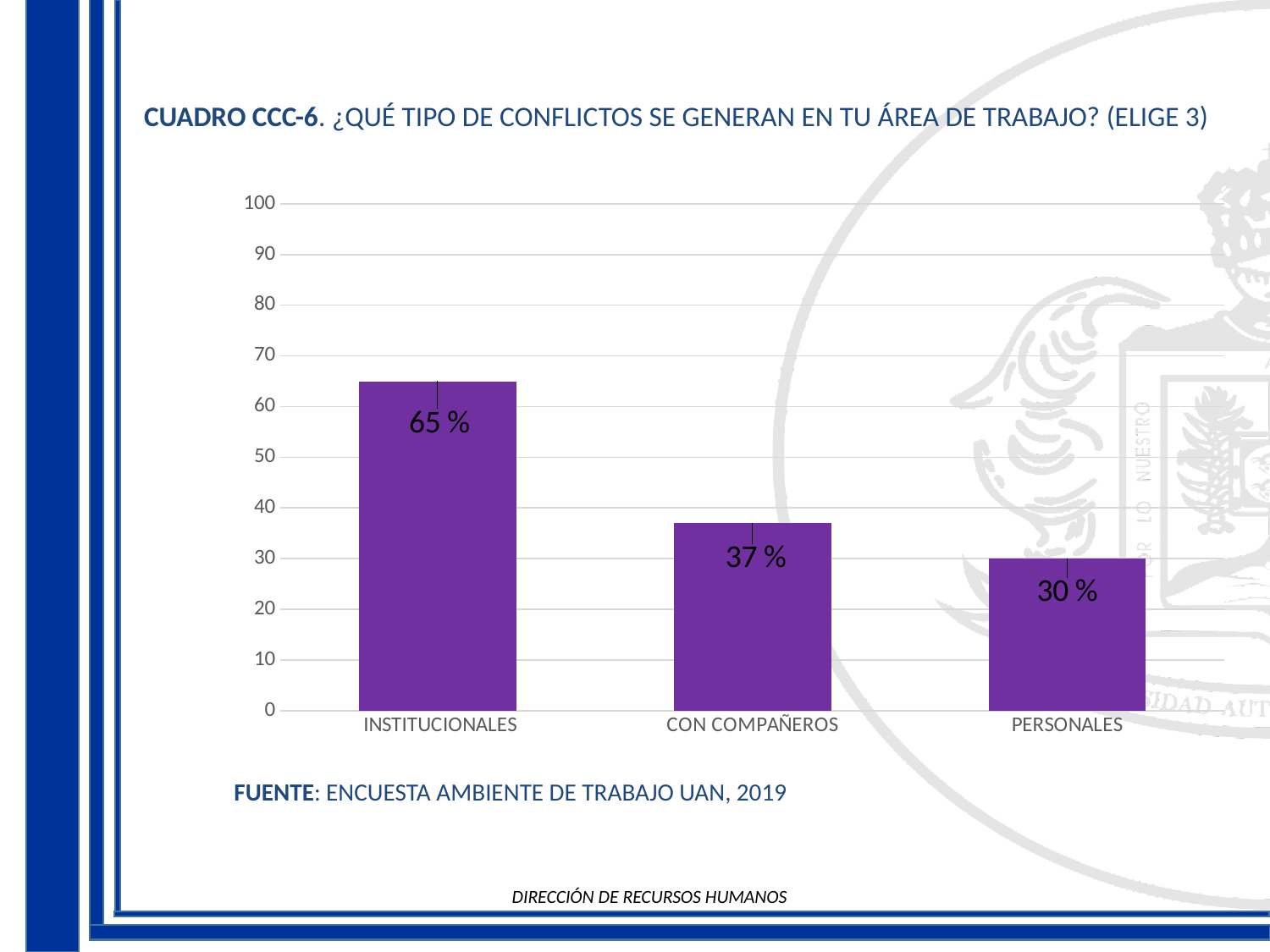
Is the value for INSTITUCIONALES greater or less than 60? greater Do the values rise or fall from left to right along the x axis? fall What is the value for PERSONALES? 30 % How many categories are shown on the x axis? 3 Which category has the lowest value? PERSONALES What is the difference between the values for CON COMPAÑEROS and PERSONALES? 7 % What kind of chart is shown on the slide? bar chart Which is larger, the value for CON COMPAÑEROS or the value for PERSONALES? CON COMPAÑEROS What is the difference between the values for INSTITUCIONALES and CON COMPAÑEROS? 28 % Which category has the highest value? INSTITUCIONALES What is the value for INSTITUCIONALES? 65 % What is the value for CON COMPAÑEROS? 37 %